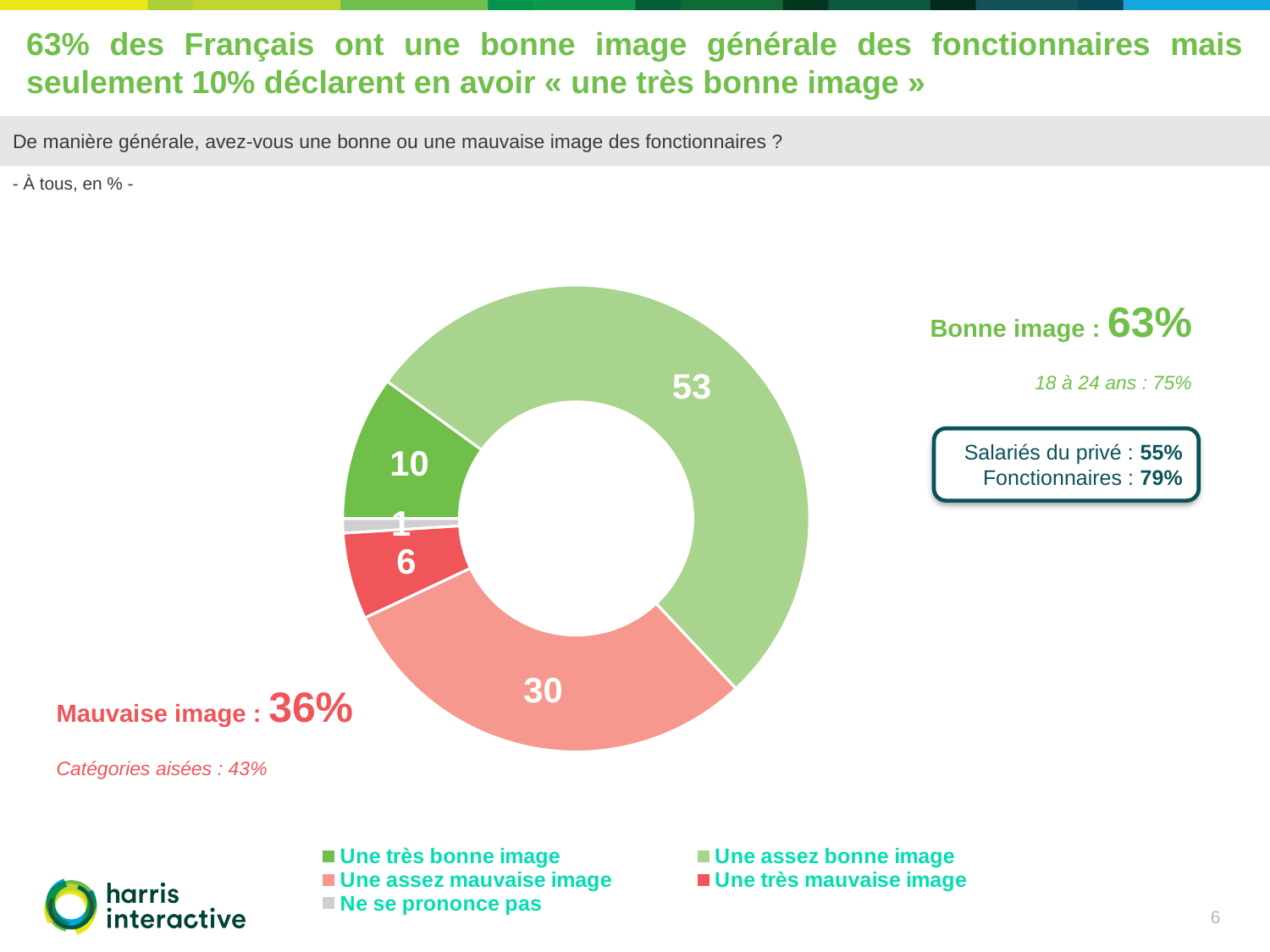
What is the difference between the values for "Une assez bonne image" and "Une assez mauvaise image"? 23 What is the value for "Une très mauvaise image"? 6 Which category has the smallest slice of the chart? Ne se prononce pas How many categories does the legend list? 5 What is the value for "Une assez mauvaise image"? 30 What is the value for "Une très bonne image"? 10 What colour is the slice for "Une très mauvaise image"? Red What is the value for "Une assez bonne image"? 53 What kind of chart is shown on the slide? Pie chart (donut) Which is larger, the value for "Une très bonne image" or the value for "Une très mauvaise image"? Une très bonne image What is the value for "Ne se prononce pas"? 1 Which category has the largest slice of the chart? Une assez bonne image